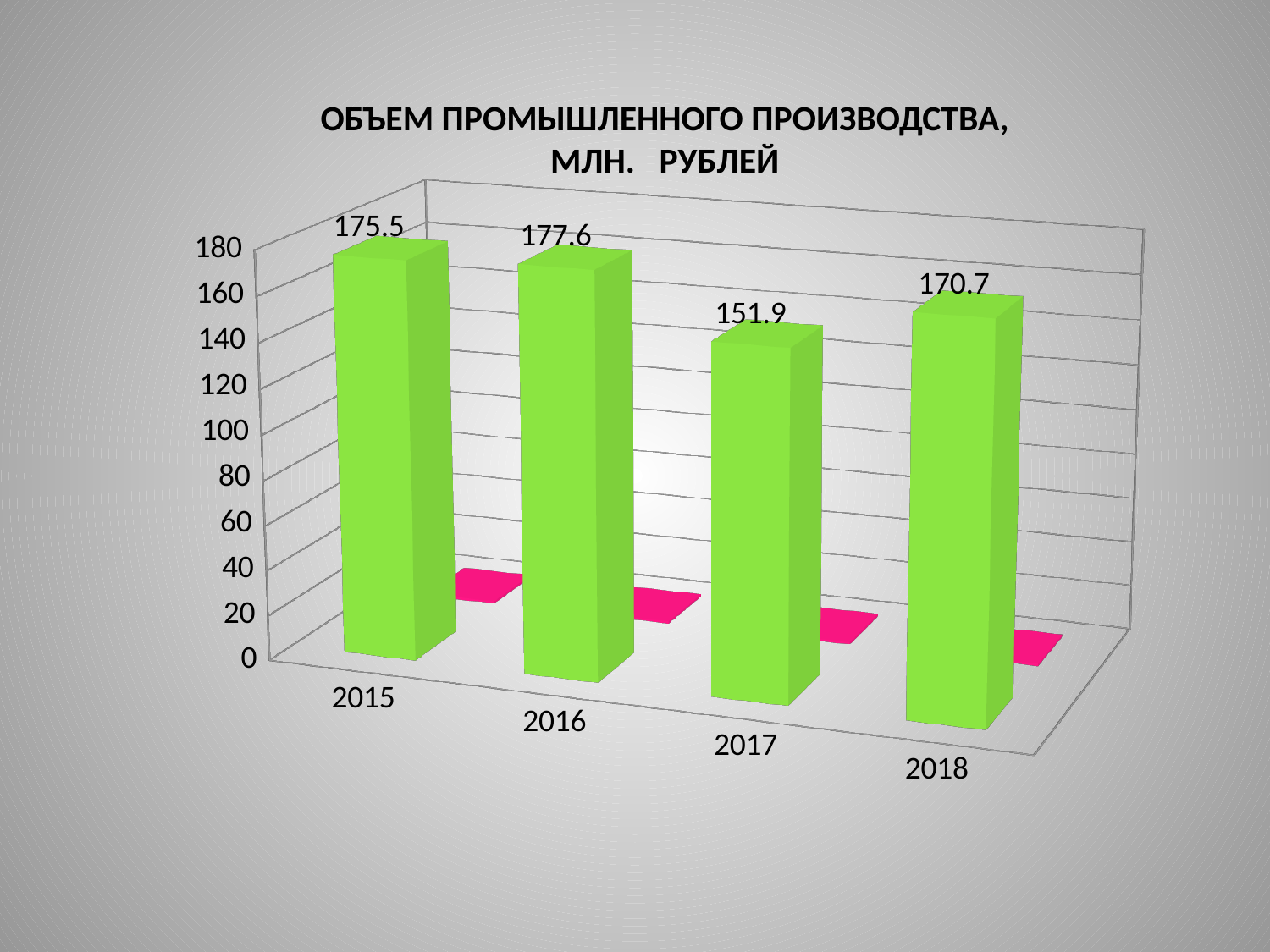
Which year has the highest value? 2016 What is the difference between the values for 2016 and 2017? 25.7 What is the difference between the values for 2015 and 2018? 4.8 What kind of chart is this? bar chart What is the value for 2016? 177.6 How many years are shown on the x axis? 4 What is the value for 2018? 170.7 What is the title of the chart? ОБЪЕМ ПРОМЫШЛЕННОГО ПРОИЗВОДСТВА, МЛН. РУБЛЕЙ What is the value for 2017? 151.9 Which is larger, the value for 2017 or the value for 2018? 2018 What is the value for 2015? 175.5 Which year has the lowest value? 2017